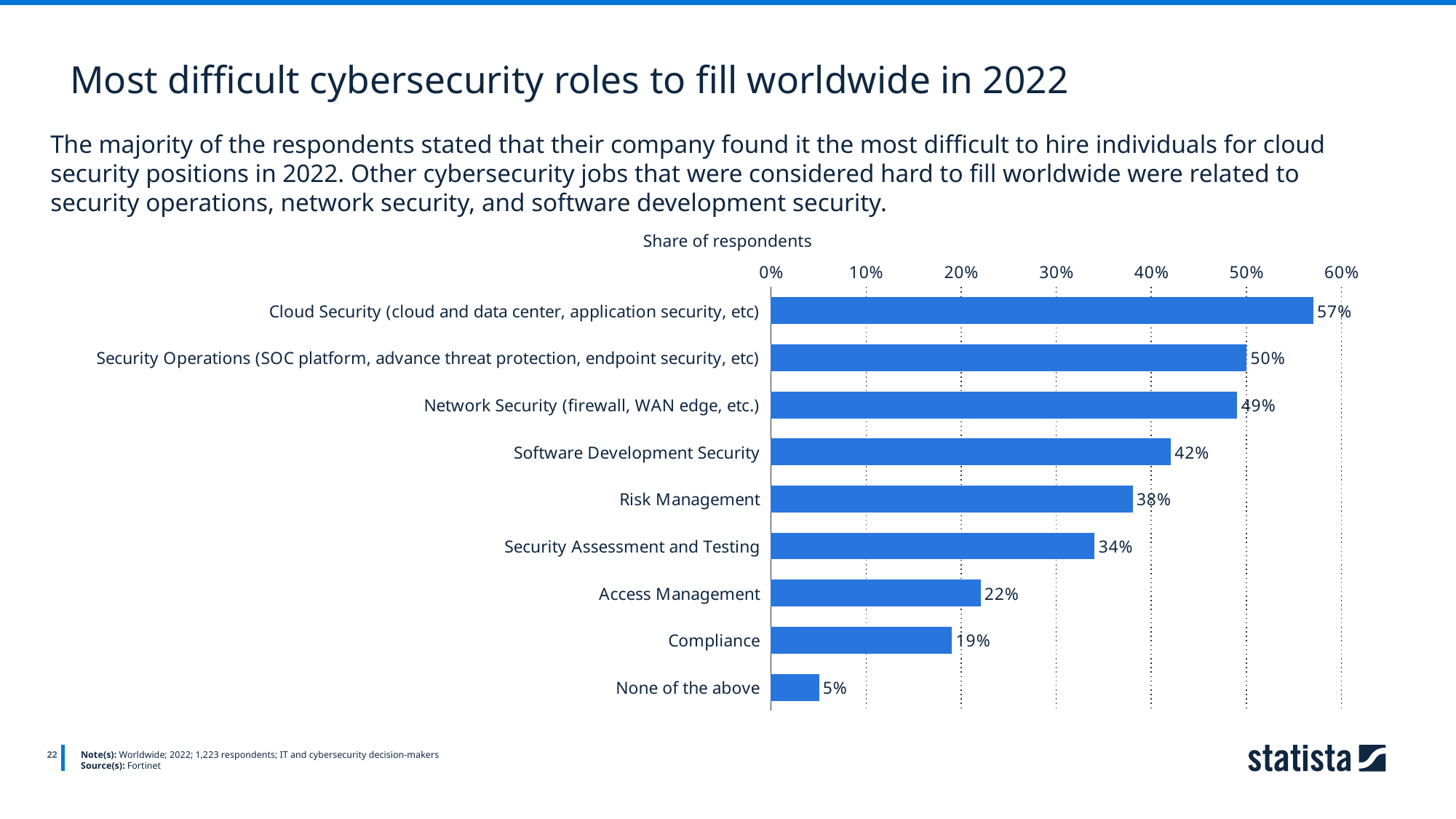
What is the value for Compliance? 19% What is the label above the chart's axis? Share of respondents What kind of chart is shown on the slide? Bar chart Which category has the lowest share of respondents? None of the above Which category has the highest share of respondents? Cloud Security (cloud and data center, application security, etc) How many categories are shown in the chart? 9 What share of respondents found Cloud Security roles difficult to fill? 57% What is the difference between the values for Cloud Security and None of the above? 52% What is the value for Risk Management? 38% Is the value for Network Security greater or less than 40%? greater What is the difference between the values for Security Operations and Software Development Security? 8% Which is larger, the value for Access Management or the value for Security Assessment and Testing? Security Assessment and Testing